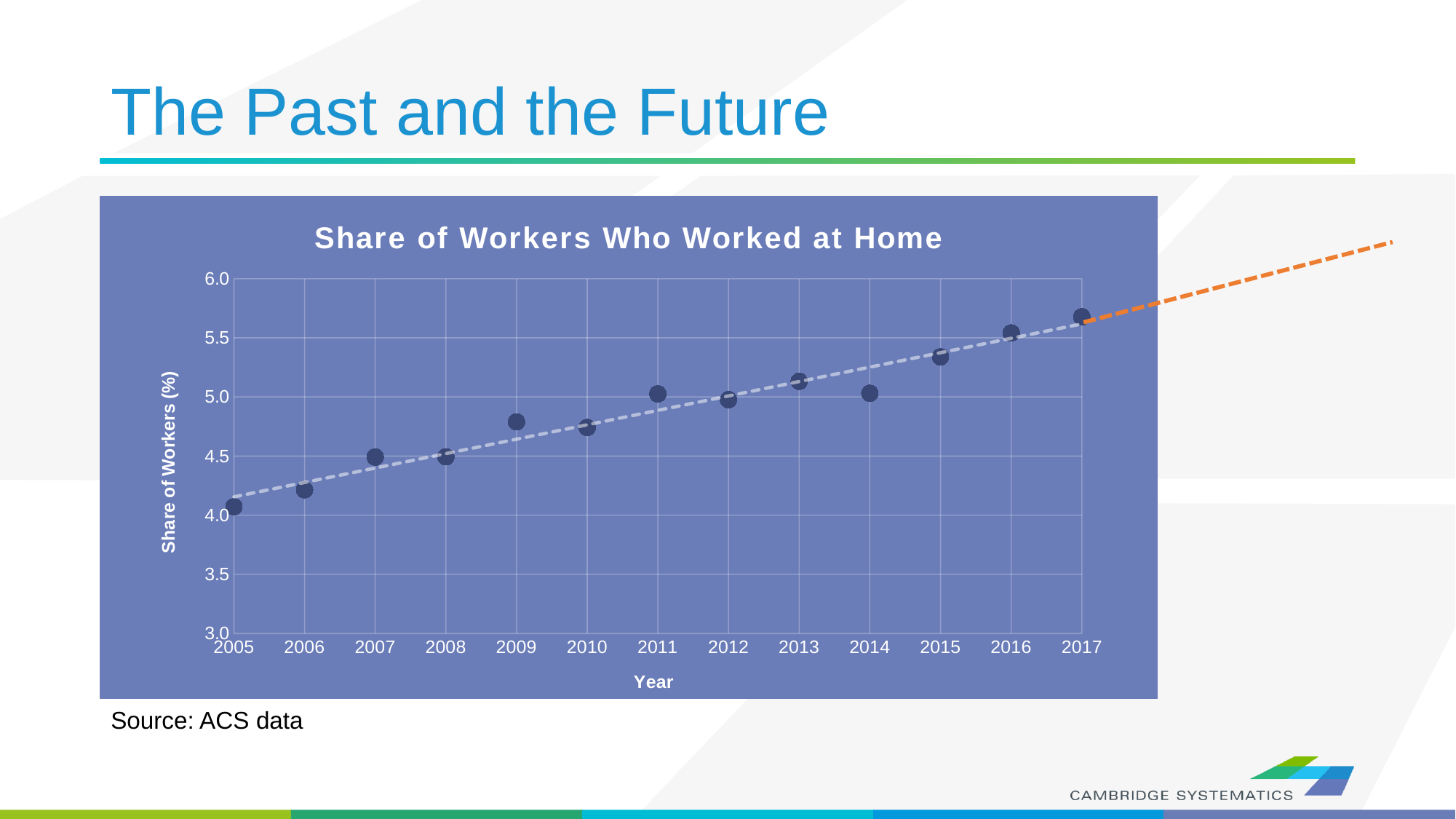
Is the value for 2015 greater or less than 5.0? greater What type of chart is shown on the slide? Scatter plot What is the label of the y axis? Share of Workers (%) Is the value for 2010 greater or less than 5.0? less What is the title of the chart? Share of Workers Who Worked at Home Which year has the highest share of workers who worked at home? 2017 Is the value for 2005 greater or less than 4.5? less Which year has the lowest share of workers who worked at home? 2005 Do the values generally rise or fall from 2005 to 2017? Rise Which year has a larger value, 2009 or 2006? 2009 How many data points are plotted in the chart? 13